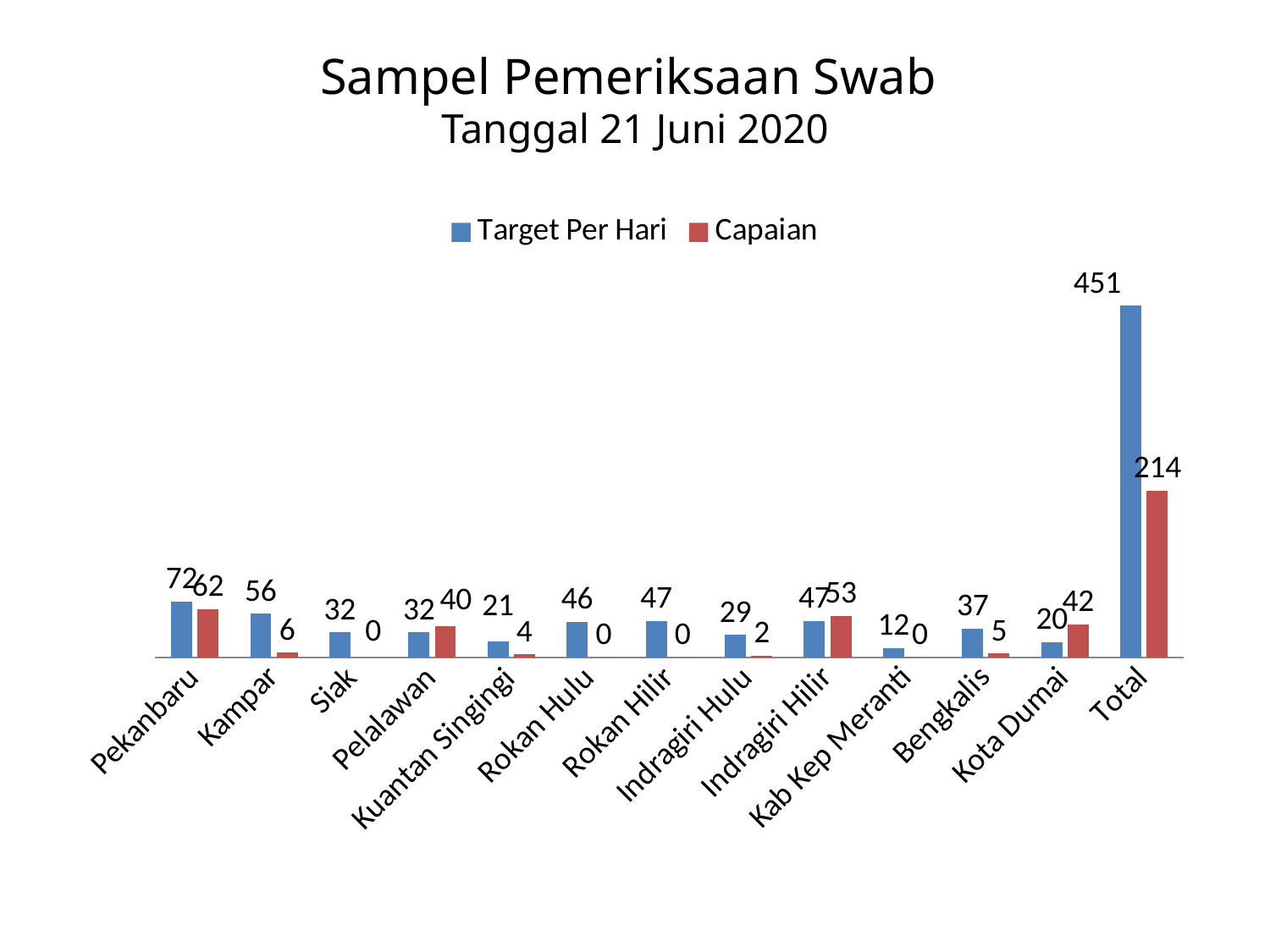
What kind of chart is shown on the slide? Bar chart Excluding the Total category, which region has the highest Target Per Hari? Pekanbaru How many series does the legend list? 2 What is the difference between Target Per Hari and Capaian for Kampar? 50 What is the Capaian value for the Total category? 214 How many categories are shown on the x axis? 13 What is the Capaian value for Siak? 0 What is the difference between Target Per Hari and Capaian for the Total category? 237 For Pelalawan, which is larger: Target Per Hari or Capaian? Capaian What is the Target Per Hari value for Pekanbaru? 72 Which category has the lowest Target Per Hari? Kab Kep Meranti What is the Capaian value for Kota Dumai? 42